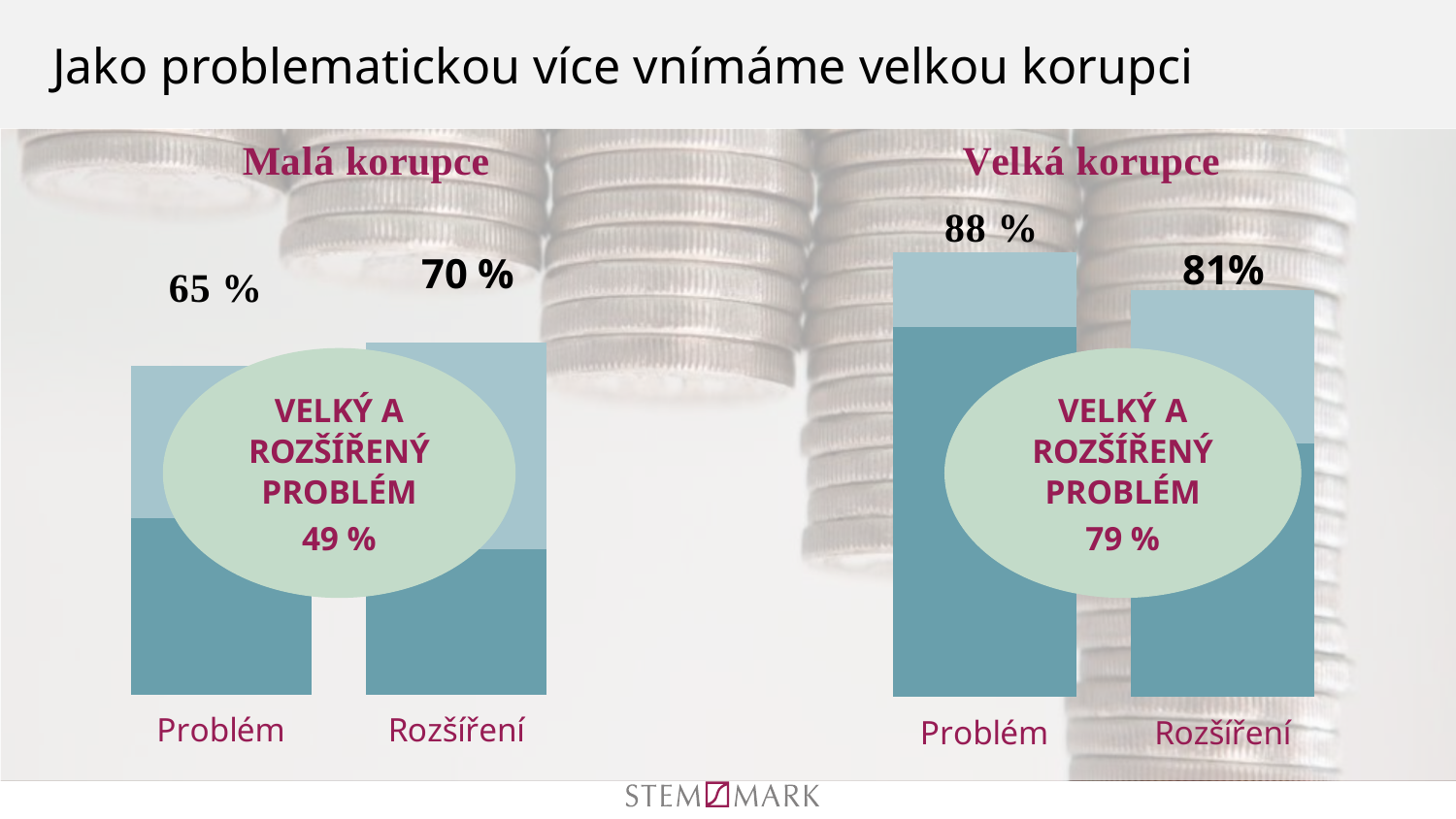
In the Velká korupce chart, what is the value for Rozšíření? 81% In the Velká korupce chart, which bar is higher, Problém or Rozšíření? Problém What percentage is shown in the oval labelled 'Velký a rozšířený problém' on the Malá korupce chart? 49 % In the Velká korupce chart, what is the value for Problém? 88 % In the Malá korupce chart, which bar is higher, Problém or Rozšíření? Rozšíření In the Velká korupce chart, what is the difference between the Problém and Rozšíření values? 7 % What percentage is shown in the oval labelled 'Velký a rozšířený problém' on the Velká korupce chart? 79 % In the Malá korupce chart, what is the value for Problém? 65 % How many bars does the Velká korupce chart show? 2 What type of chart is used for Malá korupce? Bar chart In the Malá korupce chart, what is the difference between the Rozšíření and Problém values? 5 % In the Malá korupce chart, what is the value for Rozšíření? 70 %